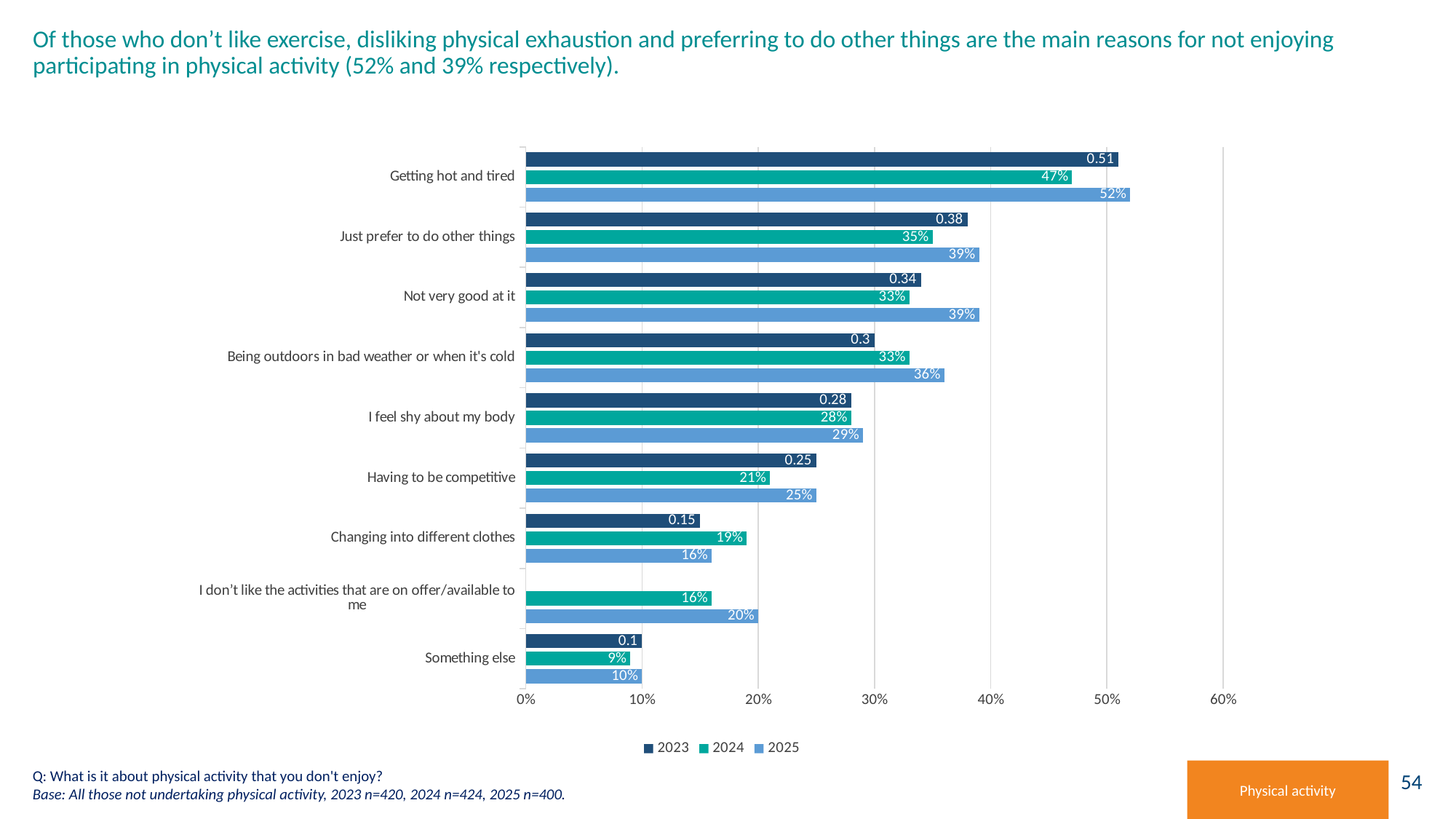
What is the difference between the 2025 and 2024 values for "Getting hot and tired"? 5% Which series is shown in the darkest blue colour? 2023 What is the 2025 value for "Getting hot and tired"? 52% Which category has the highest 2025 value? Getting hot and tired What is the 2025 value for "I don't like the activities that are on offer/available to me"? 20% Which is larger for "Changing into different clothes": the 2024 value or the 2025 value? 2024 What is the 2023 value for "Not very good at it"? 0.34 Which category has the lowest 2024 value? Something else How many series does the legend list? 3 What is the 2024 value for "Just prefer to do other things"? 35% How many categories are shown on the chart? 9 What kind of chart is shown on the slide? Bar chart